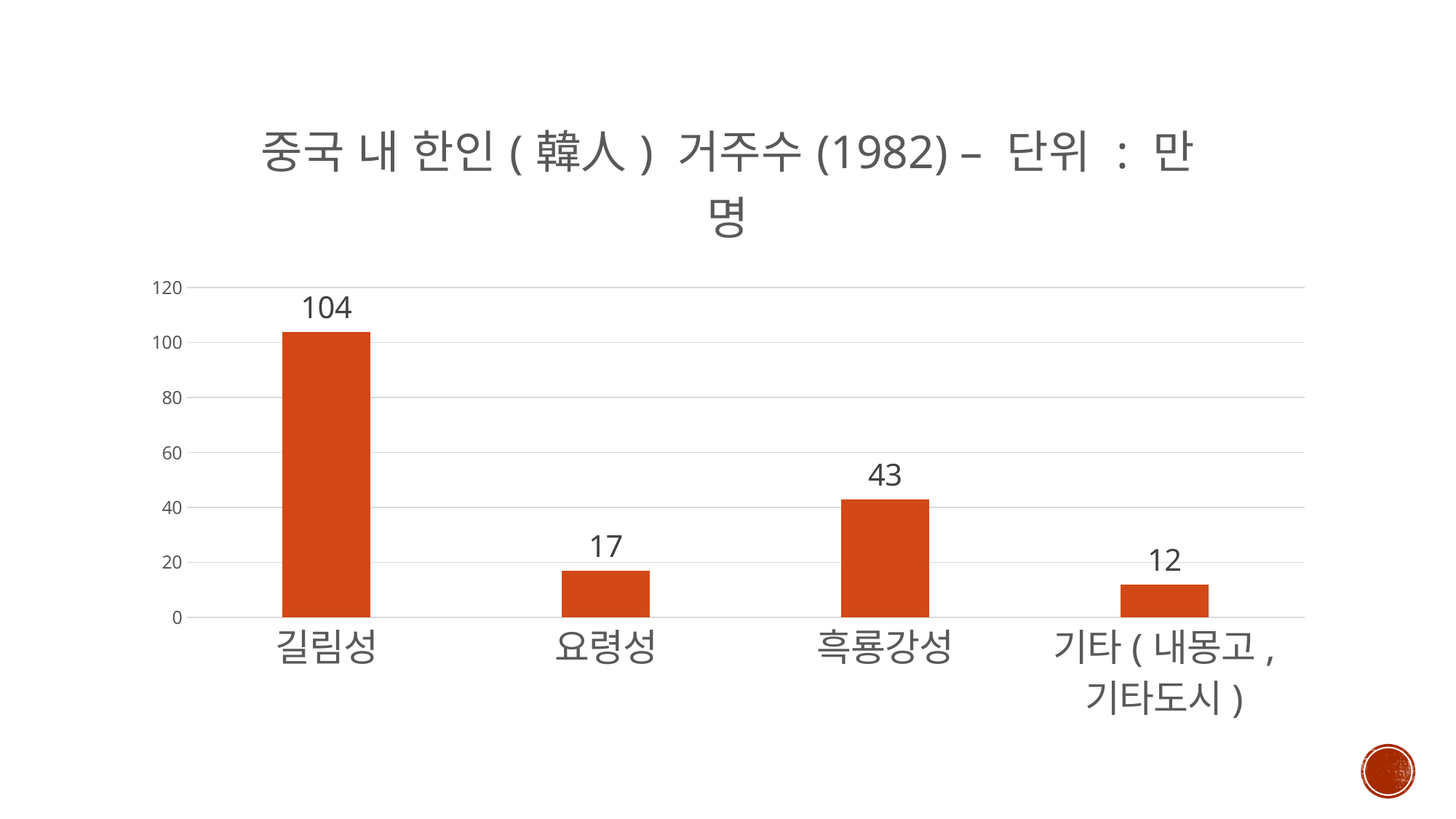
What kind of chart is shown on the slide? bar chart What is the difference between the values for 길림성 and 흑룡강성? 61 What is the value for 요령성? 17 What is the title of the chart? 중국 내 한인 ( 韓人 ) 거주수 (1982) – 단위 : 만명 What is the value for 기타 ( 내몽고 , 기타도시 )? 12 What is the value for 길림성? 104 How many categories are shown on the x axis? 4 Is the value for 흑룡강성 greater or less than 40? greater Which category has the highest value? 길림성 Which category has the lowest value? 기타 ( 내몽고 , 기타도시 ) What is the value for 흑룡강성? 43 Which is larger, the value for 요령성 or the value for 흑룡강성? 흑룡강성